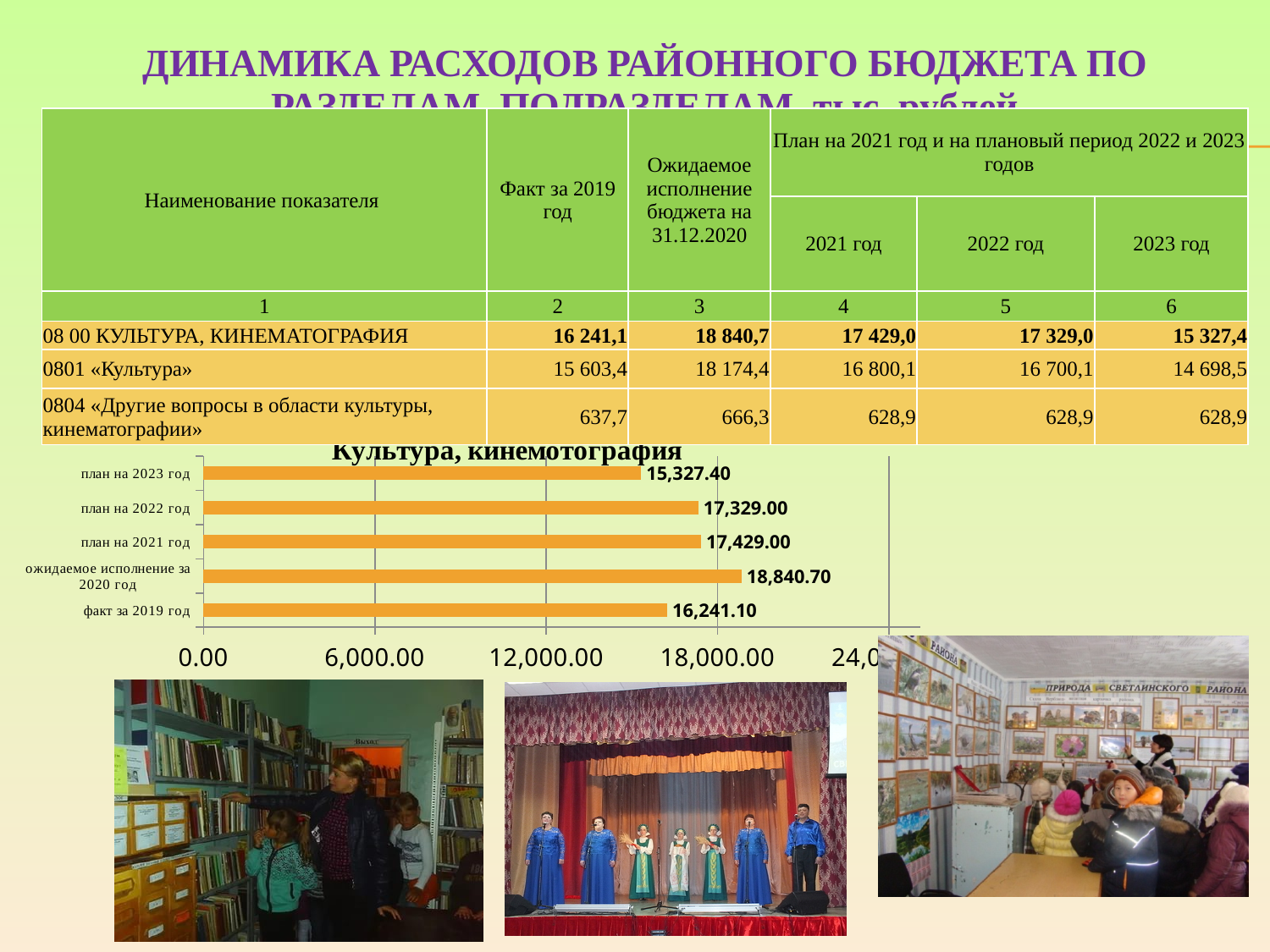
How many bars does the chart have? 5 Which category has the highest value? ожидаемое исполнение за 2020 год What is the value for 'план на 2023 год'? 15,327.40 What is the title of the chart? Культура, кинемотография What is the value for 'ожидаемое исполнение за 2020 год'? 18,840.70 What is the difference between 'план на 2021 год' and 'план на 2022 год'? 100.00 Which category has the lowest value? план на 2023 год What type of chart is shown on the slide? bar chart What is the value for 'факт за 2019 год'? 16,241.10 What is the value for 'план на 2021 год'? 17,429.00 Which is larger: 'факт за 2019 год' or 'план на 2023 год'? факт за 2019 год Is the value for 'ожидаемое исполнение за 2020 год' greater or less than 18,000.00? greater